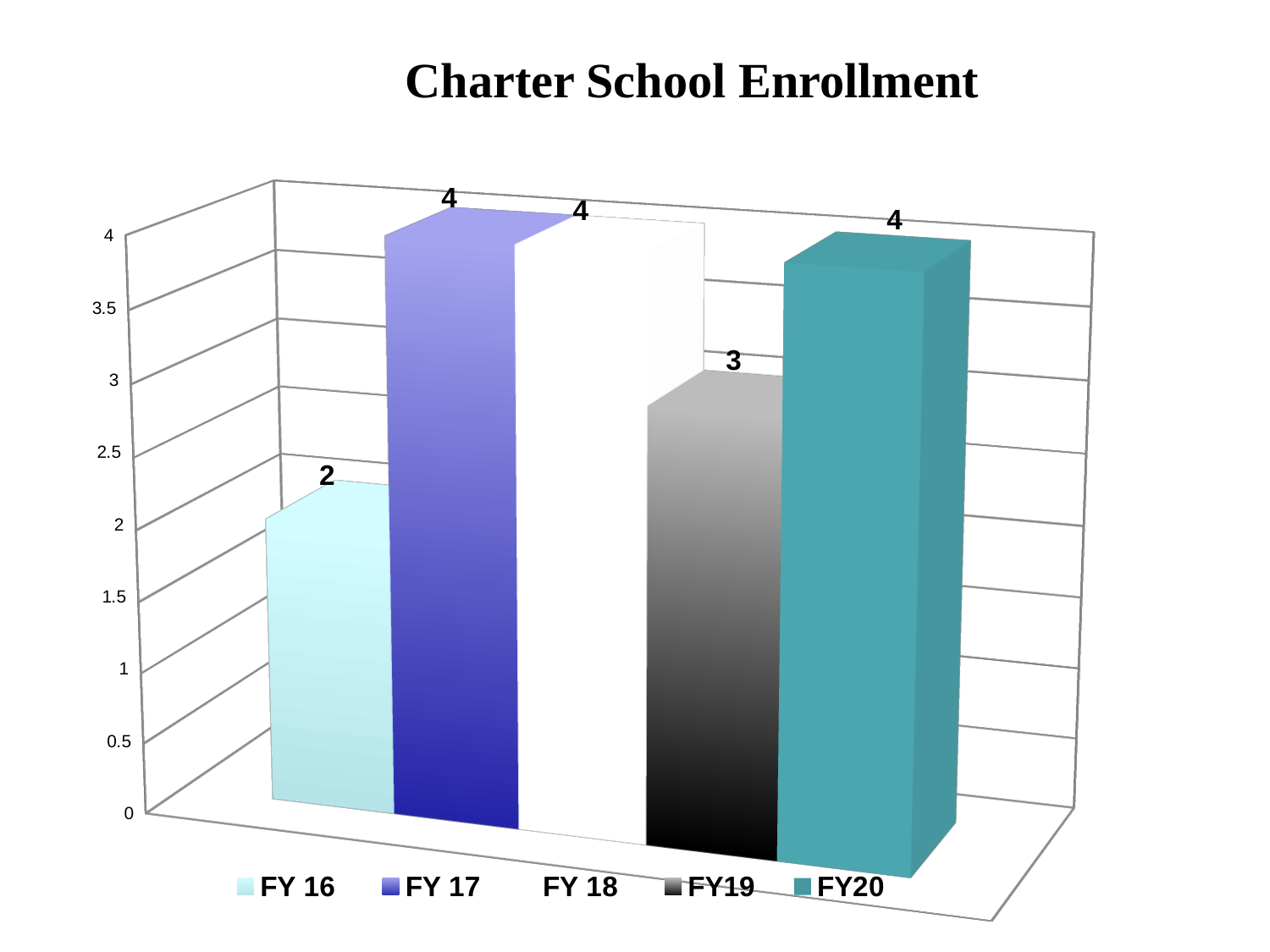
What is the value for FY19? 3 What is the value for FY 17? 4 Is the value for FY19 greater or less than 2.5? greater Which is larger, the value for FY19 or the value for FY 18? FY 18 What is the value for FY 16 in the Charter School Enrollment chart? 2 What kind of chart is shown on the slide? bar chart What is the difference between the values for FY20 and FY19? 1 What is the difference between the values for FY 17 and FY 16? 2 How many entries does the legend list? 5 What is the value for FY20? 4 How many bars are plotted in the chart? 5 Which fiscal year has the lowest enrollment value? FY 16